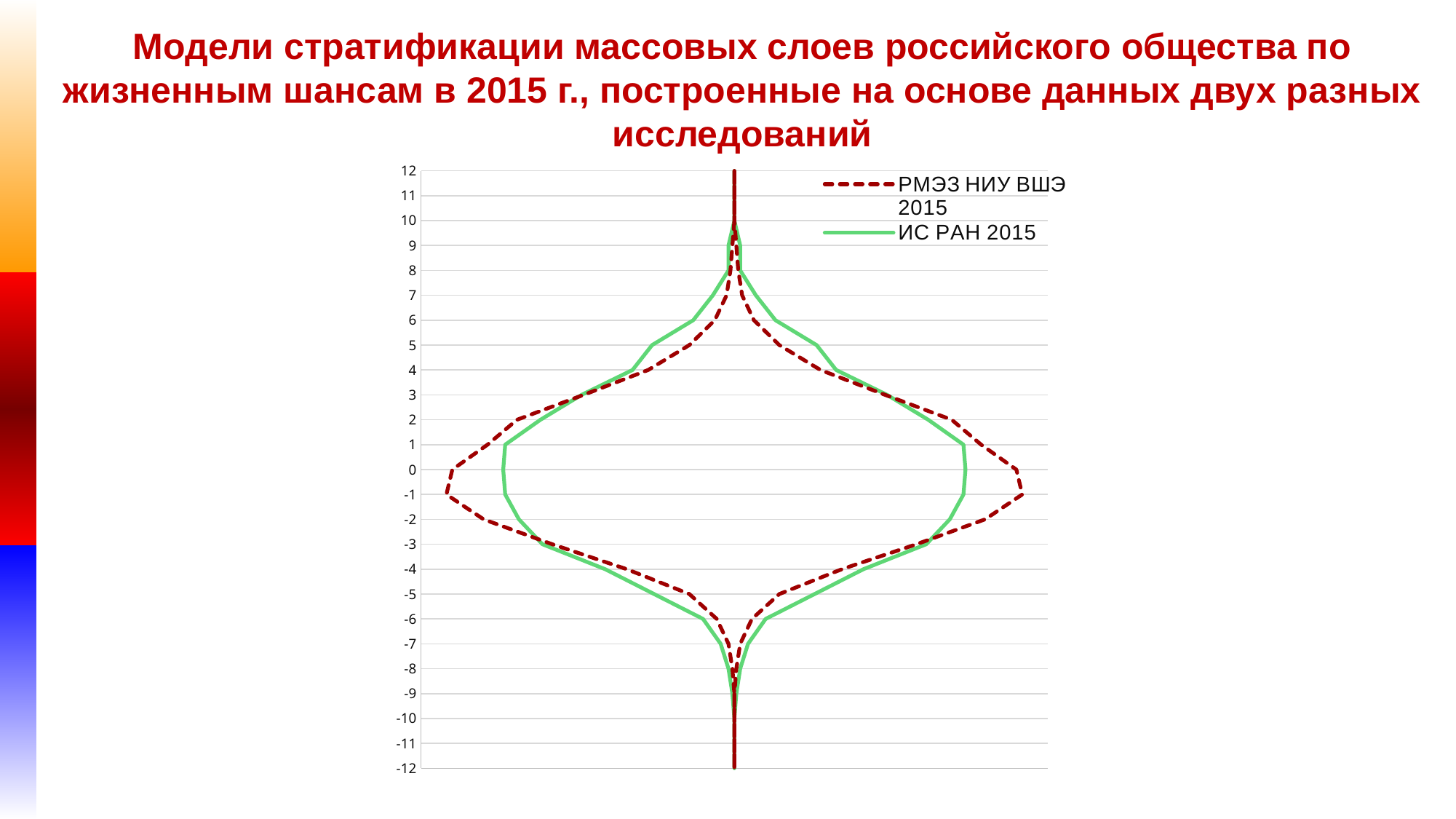
What is the highest value shown on the vertical axis? 12 Which series is drawn with a dashed line? РМЭЗ НИУ ВШЭ 2015 What kind of chart is shown on the slide? Line chart At vertical axis level 4, which series extends wider from the centre, РМЭЗ НИУ ВШЭ 2015 or ИС РАН 2015? ИС РАН 2015 What is the lowest value shown on the vertical axis? -12 At vertical axis level -5, which series extends wider from the centre, РМЭЗ НИУ ВШЭ 2015 or ИС РАН 2015? ИС РАН 2015 Does the width of the РМЭЗ НИУ ВШЭ 2015 shape increase or decrease as the vertical axis goes from 0 up to 8? Decrease How many tick labels are shown on the vertical axis? 25 How many series does the legend list? 2 At vertical axis level 0, which series extends wider from the centre, РМЭЗ НИУ ВШЭ 2015 or ИС РАН 2015? РМЭЗ НИУ ВШЭ 2015 What are the two series named in the legend? РМЭЗ НИУ ВШЭ 2015 and ИС РАН 2015 At which vertical axis level does the ИС РАН 2015 series reach its widest point? Between 1 and -1